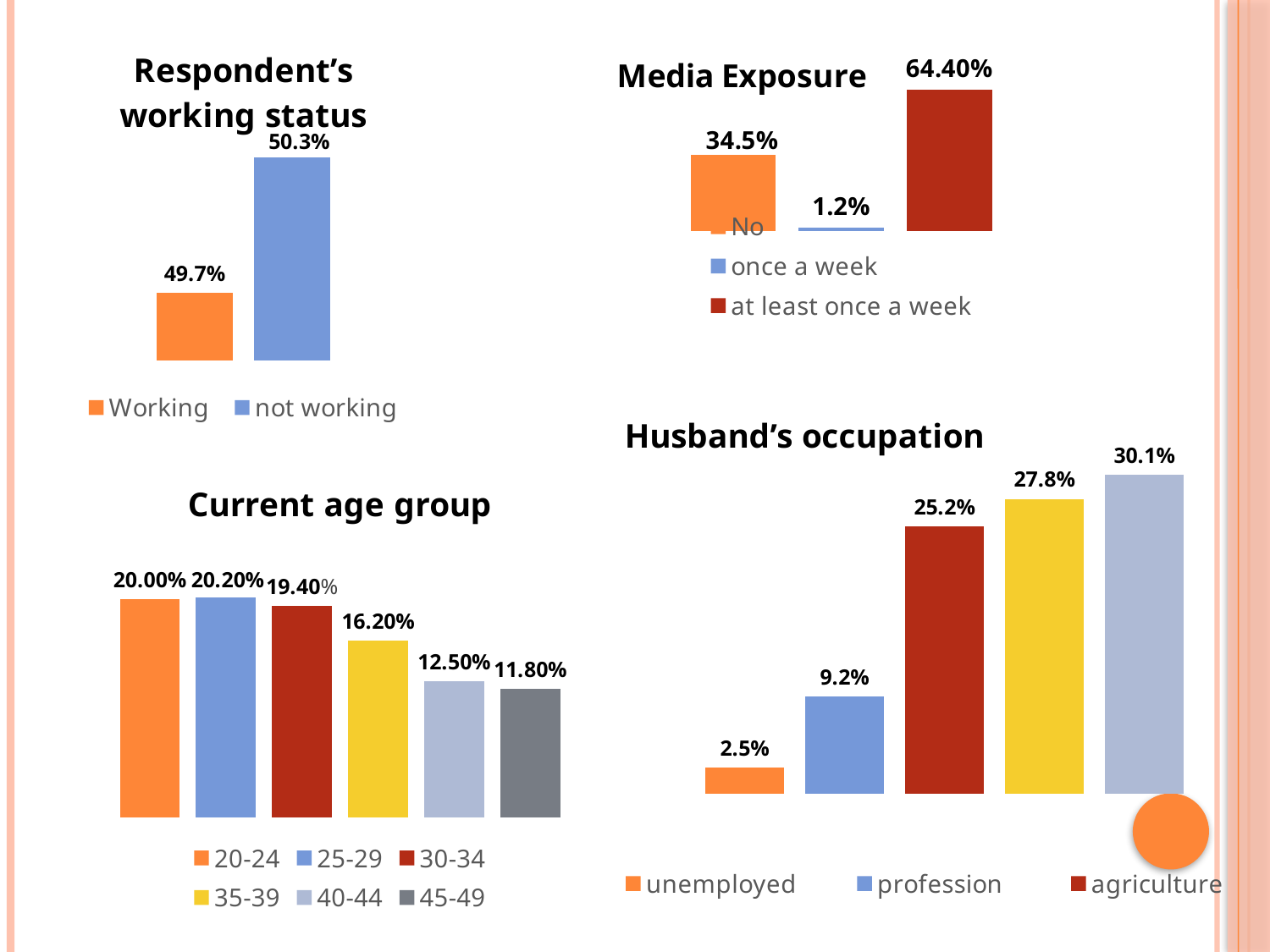
In the 'Husband's occupation' chart, what is the difference between profession and unemployed? 6.7% In the 'Media Exposure' chart, what is the value for 'at least once a week'? 64.40% In the 'Husband's occupation' chart, what is the value for agriculture? 25.2% In the 'Respondent's working status' chart, which category is higher, Working or not working? not working In the 'Current age group' chart, which age group has the lowest value? 45-49 In the 'Media Exposure' chart, how many categories are plotted? 3 What kind of chart is the 'Husband's occupation' chart? bar chart In the 'Current age group' chart, how many age groups does the legend list? 6 In the 'Current age group' chart, what is the value for the 35-39 age group? 16.20% In the 'Respondent's working status' chart, what is the value for Working? 49.7% In the 'Media Exposure' chart, which category has the lowest value? once a week In the 'Media Exposure' chart, what is the difference between 'at least once a week' and 'No'? 29.9%